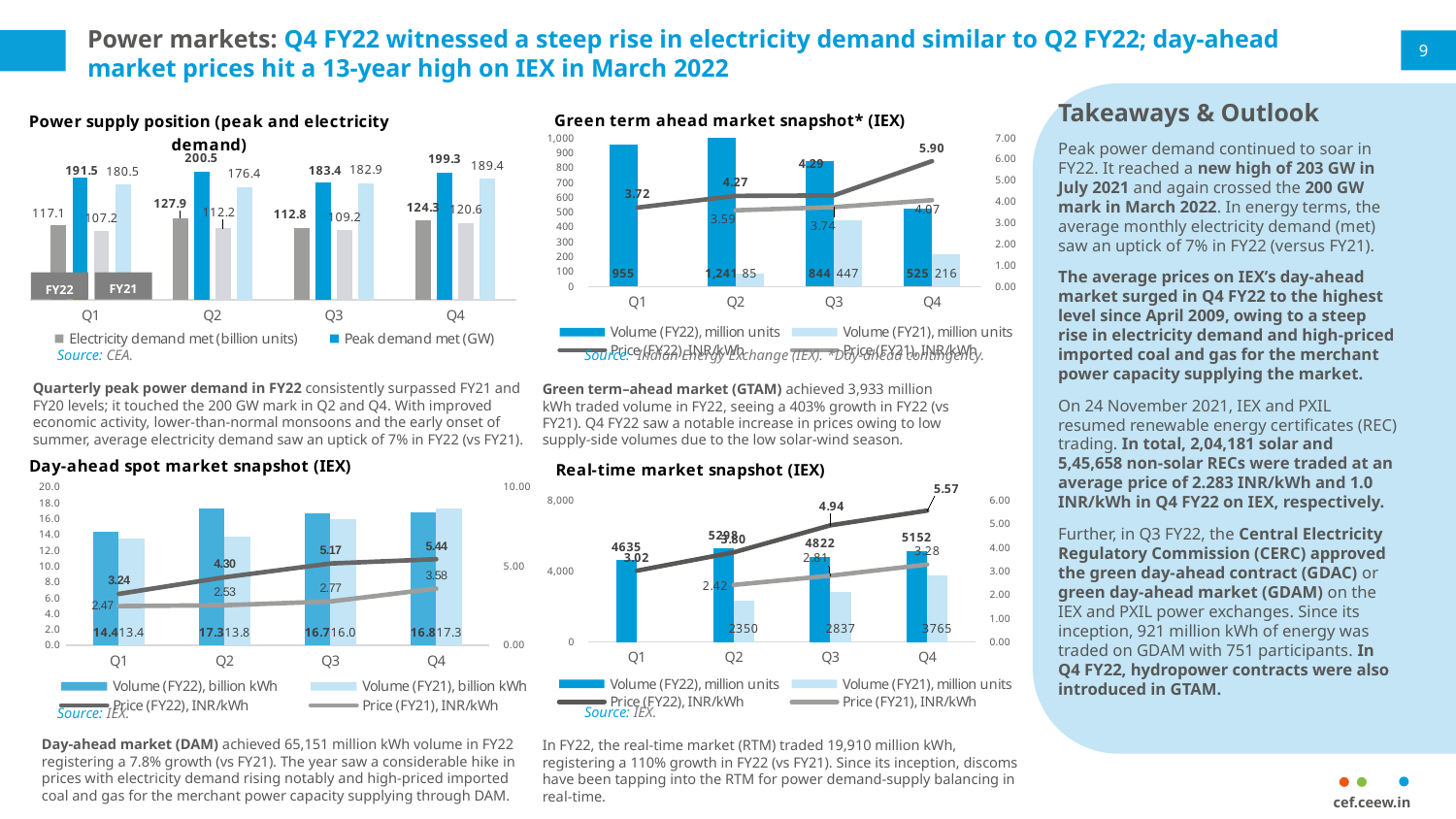
In the 'Green term ahead market snapshot* (IEX)' chart, what is the FY22 volume (million units) in Q2? 1,241 In the 'Real-time market snapshot (IEX)' chart, what is the FY22 volume (million units) in Q1? 4635 In the 'Power supply position' chart, what is the peak demand met (GW) for FY22 in Q2? 200.5 In the 'Day-ahead spot market snapshot (IEX)' chart, which is larger in Q4: FY22 volume or FY21 volume (billion kWh)? FY21 volume (17.3) In the 'Green term ahead market snapshot* (IEX)' chart, which quarter has the highest FY22 price (INR/kWh)? Q4 In the 'Power supply position' chart, which quarter has the highest electricity demand met (billion units) for FY22? Q2 In the 'Power supply position' chart, what is the difference between FY22 and FY21 peak demand met (GW) in Q1? 11.0 In the 'Day-ahead spot market snapshot (IEX)' chart, what is the FY22 price (INR/kWh) in Q3? 5.17 In the 'Real-time market snapshot (IEX)' chart, what is the difference between the FY22 and FY21 prices (INR/kWh) in Q4? 2.29 In the 'Day-ahead spot market snapshot (IEX)' chart, does the FY22 price (INR/kWh) rise or fall from Q1 to Q4? rise How many quarters are shown on the x axis of the 'Real-time market snapshot (IEX)' chart? 4 In the 'Green term ahead market snapshot* (IEX)' chart, how many series does the legend list? 4